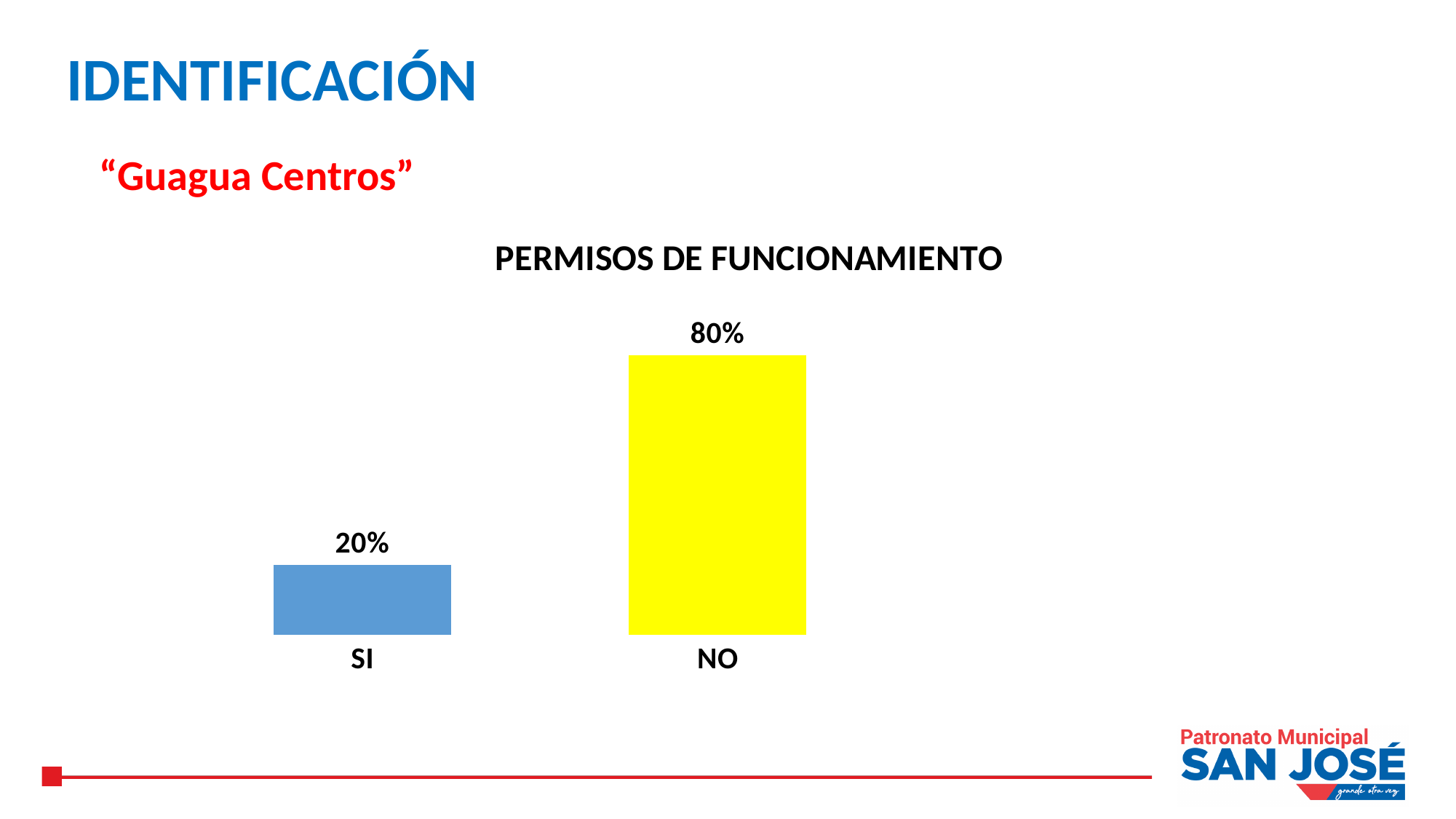
What colour is the bar for NO? Yellow What is the value for SI in the PERMISOS DE FUNCIONAMIENTO chart? 20% What is the value for NO in the PERMISOS DE FUNCIONAMIENTO chart? 80% Which category has the highest value in the chart? NO Which is larger, the value for SI or the value for NO? NO What is the difference between the values for NO and SI? 60% Which category has the lowest value in the chart? SI How many categories are shown in the chart? 2 What is the total of the values for SI and NO? 100% What kind of chart is shown on the slide? Bar chart What is the title of the chart? PERMISOS DE FUNCIONAMIENTO